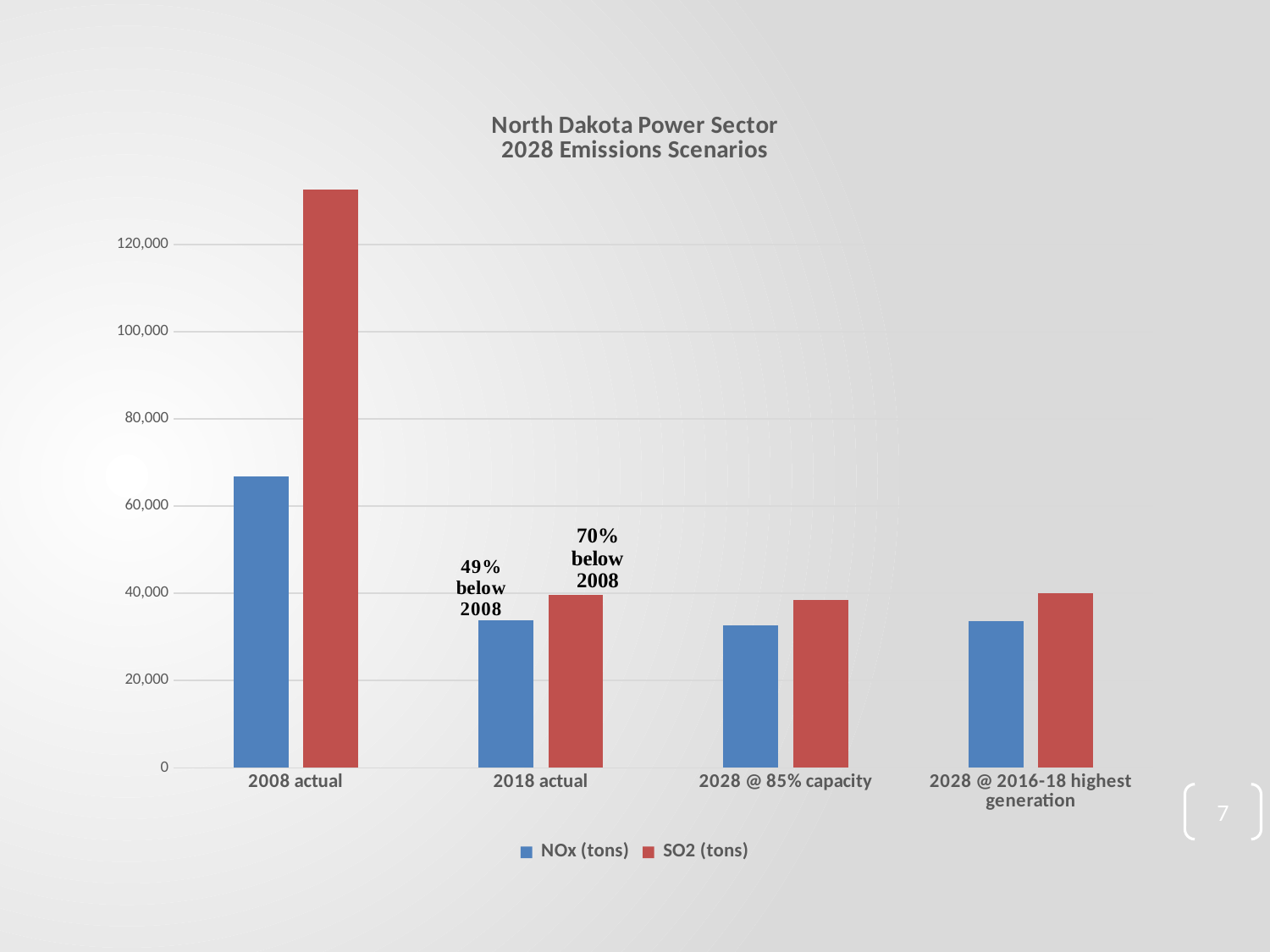
What is the title of the chart? North Dakota Power Sector 2028 Emissions Scenarios How many categories are shown on the x axis? 4 Is the SO2 (tons) value for 2008 actual greater or less than 120,000? greater How many series does the legend list? 2 Is the NOx (tons) value for 2008 actual greater or less than 60,000? greater Which category has the highest SO2 (tons) value? 2008 actual Is the NOx (tons) value for 2028 @ 85% capacity greater or less than 40,000? less Which category has the highest NOx (tons) value? 2008 actual For 2008 actual, which is larger: NOx (tons) or SO2 (tons)? SO2 (tons) According to the annotation, by what percentage is the 2018 actual NOx value below 2008? 49% What kind of chart is shown on the slide? Bar chart